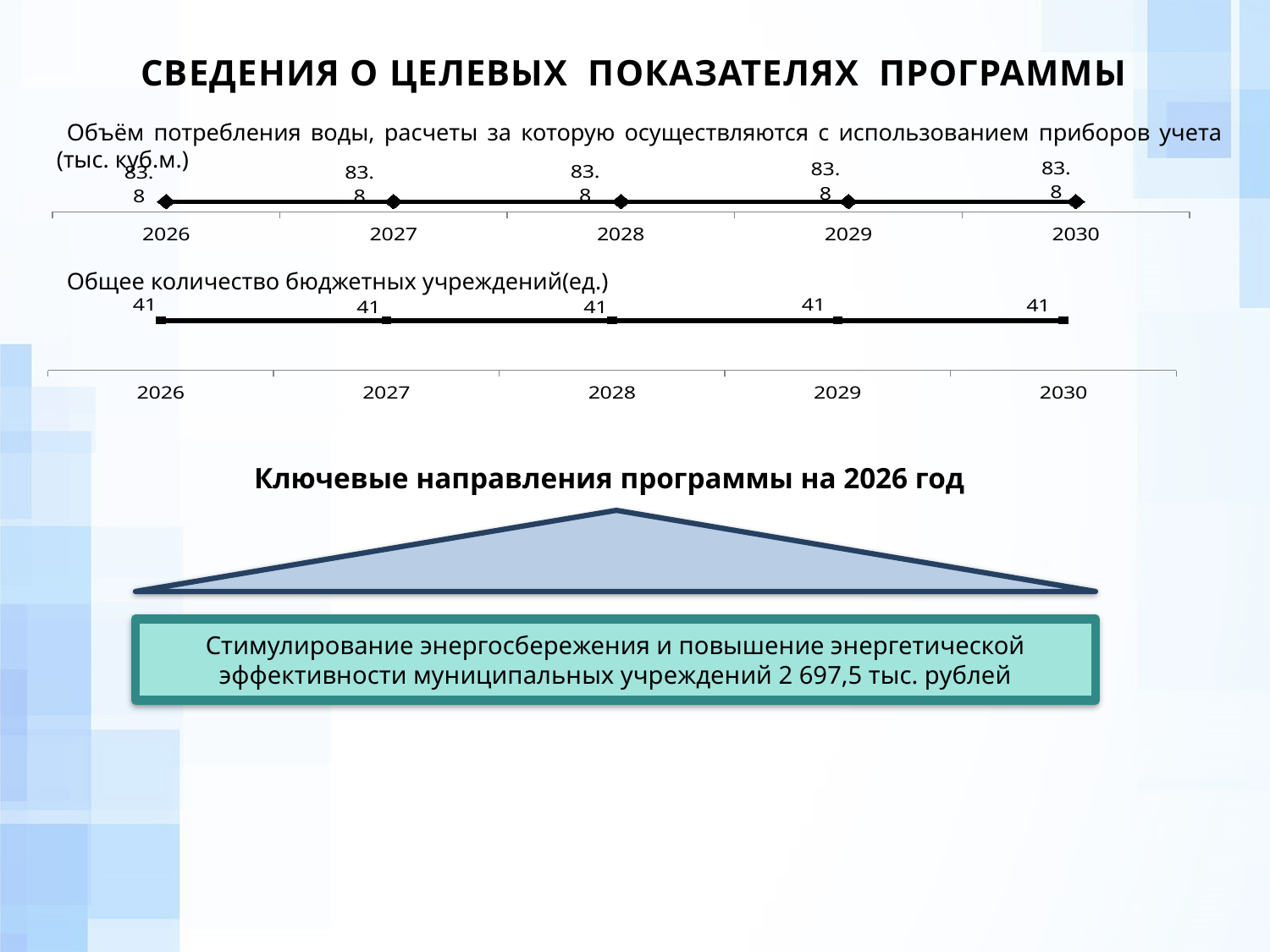
What unit is given in the title of the bottom chart (Общее количество бюджетных учреждений)? ед. What kind of chart is the bottom chart (Общее количество бюджетных учреждений)? Line chart On the top chart (Объём потребления воды), do the values rise, fall or stay flat from 2026 to 2030? Stay flat On the bottom chart (Общее количество бюджетных учреждений), do the values rise, fall or stay flat from 2026 to 2030? Stay flat On the top chart (Объём потребления воды), what is the value for 2026? 83.8 On the top chart (Объём потребления воды), what is the difference between the values for 2027 and 2029? 0 On the bottom chart (Общее количество бюджетных учреждений), what is the value for 2030? 41 On the top chart (Объём потребления воды), how many years are plotted along the x axis? 5 On the bottom chart (Общее количество бюджетных учреждений), what is the value for 2028? 41 What kind of chart is the top chart (Объём потребления воды)? Line chart On the top chart (Объём потребления воды), what is the value for 2030? 83.8 On the bottom chart (Общее количество бюджетных учреждений), how many data points are plotted? 5